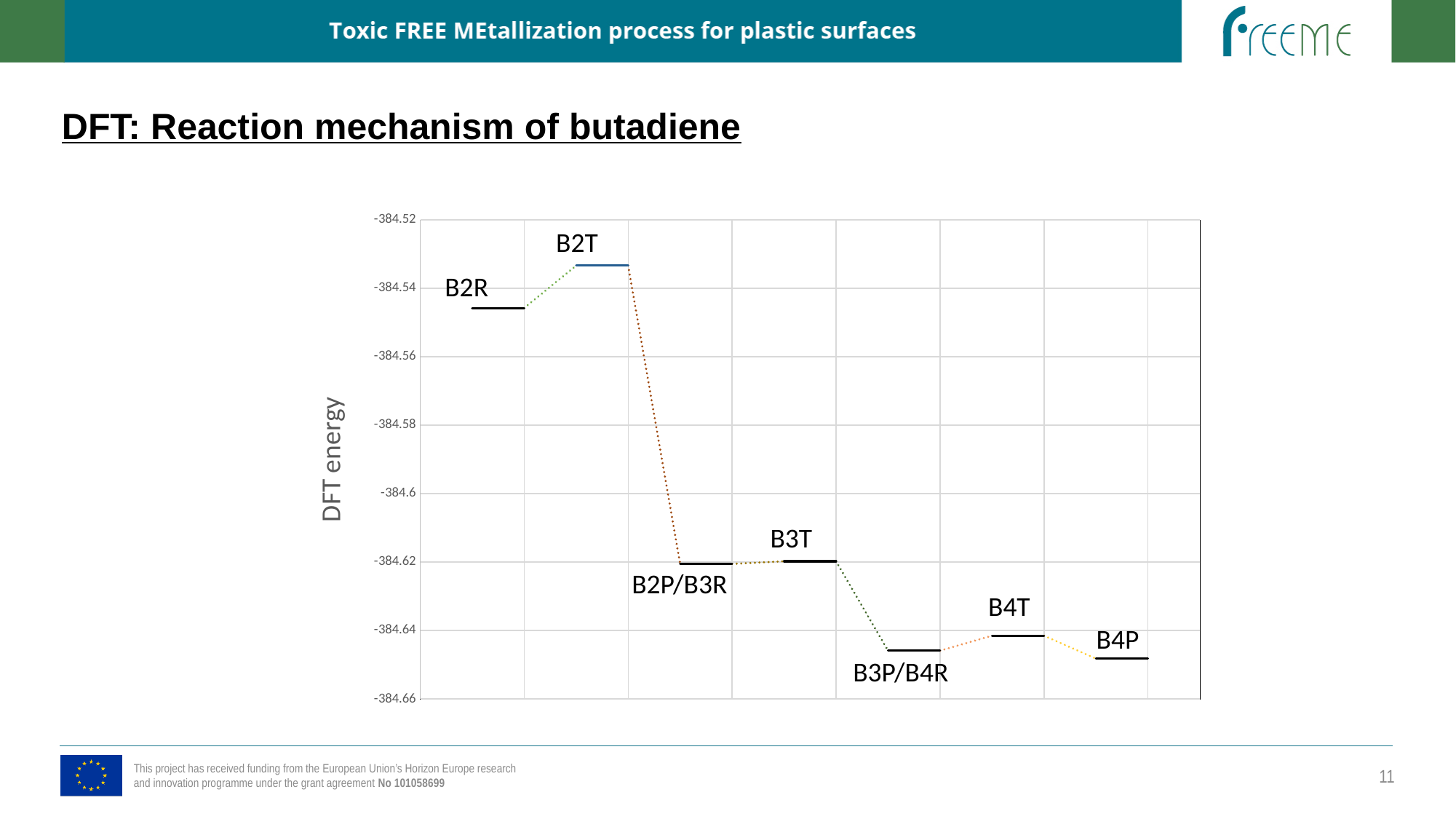
Is the DFT energy of B4P greater or less than -384.64? less Is the DFT energy of B2T greater or less than -384.54? greater Which has the higher DFT energy, B3T or B3P/B4R? B3T What kind of chart is shown on the slide? line chart Which has the higher DFT energy, B2T or B4P? B2T What is the label of the vertical axis of the chart? DFT energy Is the DFT energy of B3P/B4R greater or less than -384.64? less Overall, does the DFT energy rise or fall from B2R on the left to B4P on the right? fall Which labelled state has the highest DFT energy? B2T Which has the higher DFT energy, B2R or B2T? B2T How many labelled states (energy levels) are plotted on the chart? 7